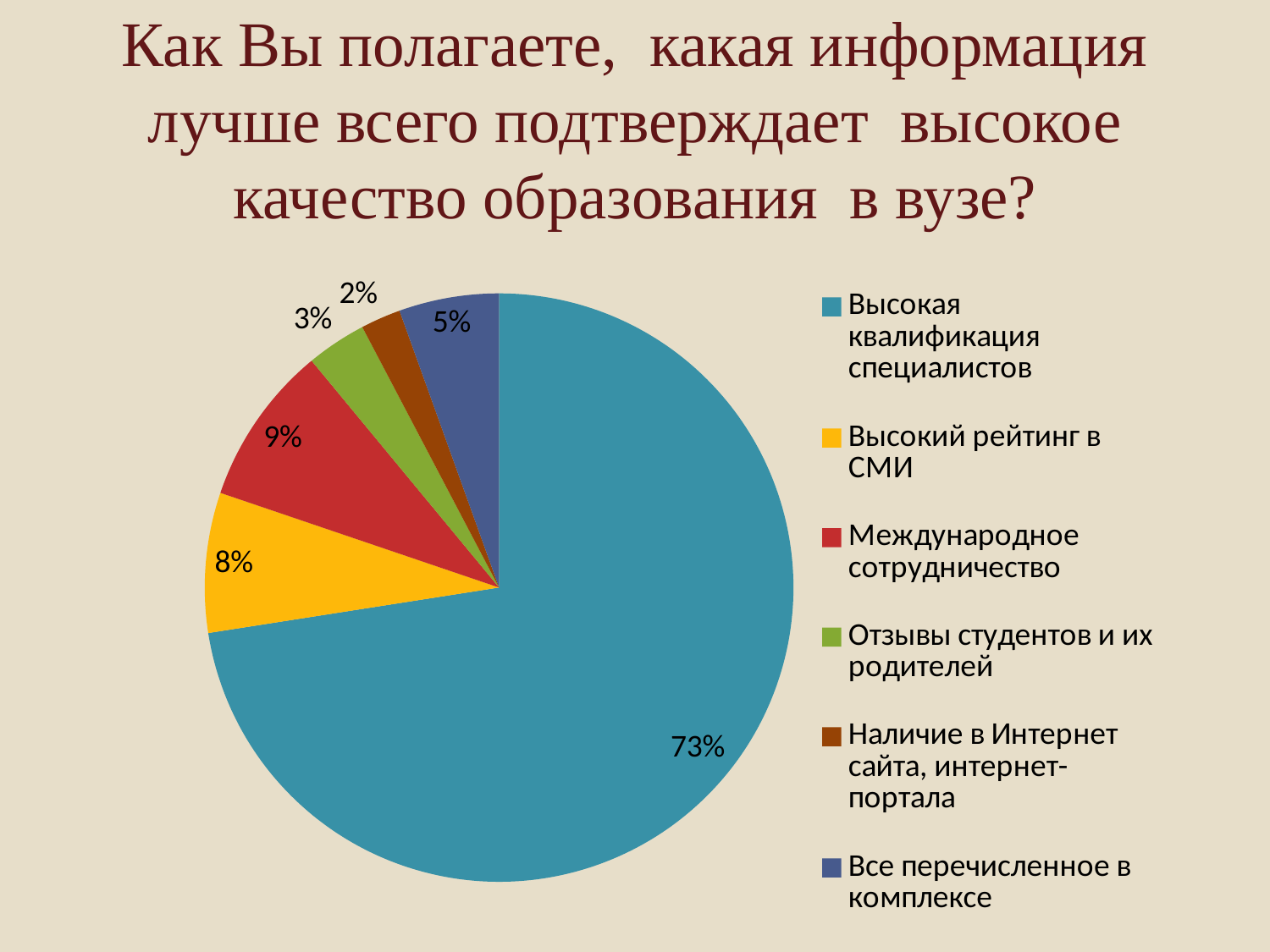
Which category has the smallest slice of the pie? Наличие в Интернет сайта, интернет-портала How many categories does the pie chart have? 6 Which category has the largest slice of the pie? Высокая квалификация специалистов What is the value shown for "Высокий рейтинг в СМИ"? 8% What is the value shown for "Наличие в Интернет сайта, интернет-портала"? 2% Which is larger: the share for "Международное сотрудничество" or for "Высокий рейтинг в СМИ"? Международное сотрудничество What is the difference between the shares of "Международное сотрудничество" and "Отзывы студентов и их родителей"? 6% What is the value shown for "Международное сотрудничество"? 9% What is the value shown for "Все перечисленное в комплексе"? 5% What colour is the slice for "Отзывы студентов и их родителей"? green What kind of chart is shown on the slide? pie chart What share of the pie does "Высокая квалификация специалистов" have? 73%